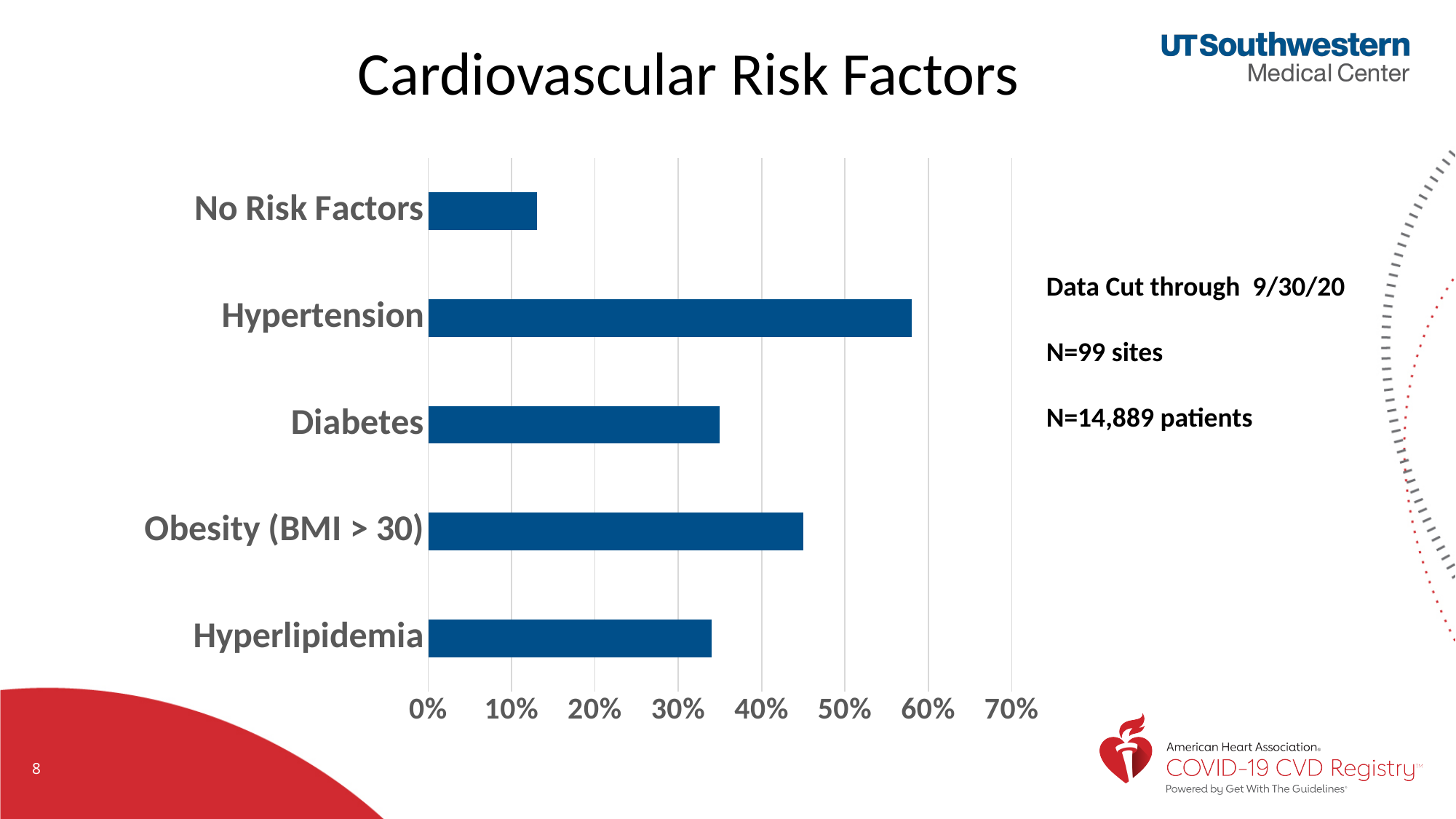
Which category has the lowest value in the chart? No Risk Factors Which category has the highest value in the chart? Hypertension What is the highest value shown on the chart's horizontal axis? 70% Is the value for Obesity (BMI > 30) greater or less than 40%? greater What kind of chart is shown on the slide? bar chart How many risk factor categories are plotted in the chart? 5 Is the value for Hyperlipidemia greater or less than 30%? greater Which is larger, the value for Hypertension or the value for Obesity (BMI > 30)? Hypertension Is the value for No Risk Factors greater or less than 20%? less What is the title of the chart on the slide? Cardiovascular Risk Factors Which is larger, the value for Diabetes or the value for No Risk Factors? Diabetes